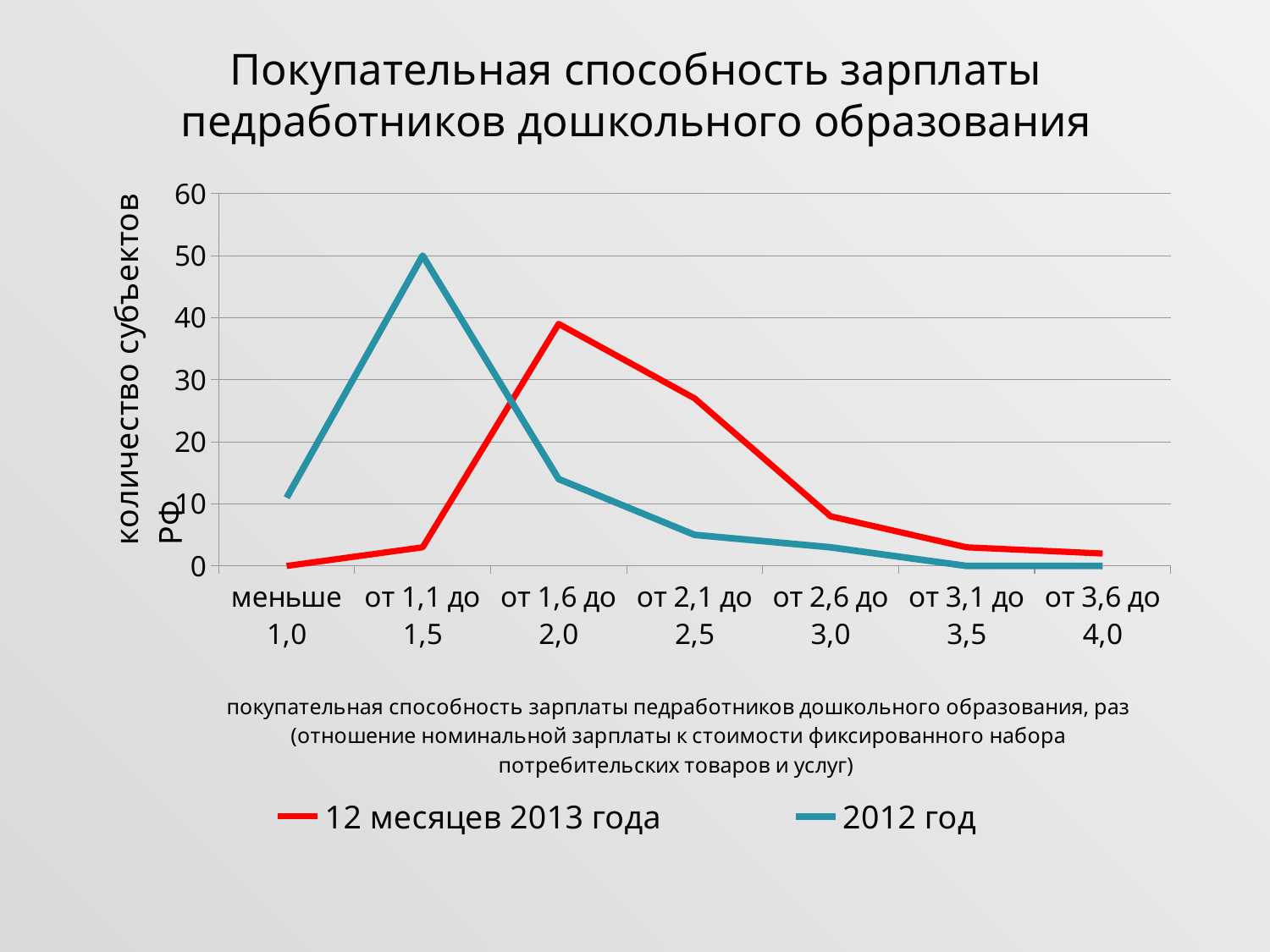
Do the values of the "12 месяцев 2013 года" series rise or fall from "от 1,6 до 2,0" to "от 3,6 до 4,0"? fall Is the value of the "12 месяцев 2013 года" series for "от 2,1 до 2,5" greater or less than 20? greater For the series "2012 год", which category has the highest value? от 1,1 до 1,5 For the series "12 месяцев 2013 года", which category has the highest value? от 1,6 до 2,0 What is the value of the "2012 год" series for the category "от 1,1 до 1,5"? 50 How many categories are shown along the x axis? 7 What are the two entries listed in the legend? 12 месяцев 2013 года; 2012 год How many series does the legend list? 2 In the category "от 1,1 до 1,5", which series has the larger value? 2012 год In the category "от 1,6 до 2,0", which series has the larger value? 12 месяцев 2013 года Is the value of the "2012 год" series for "от 2,1 до 2,5" greater or less than 10? less What kind of chart is shown on the slide? line chart